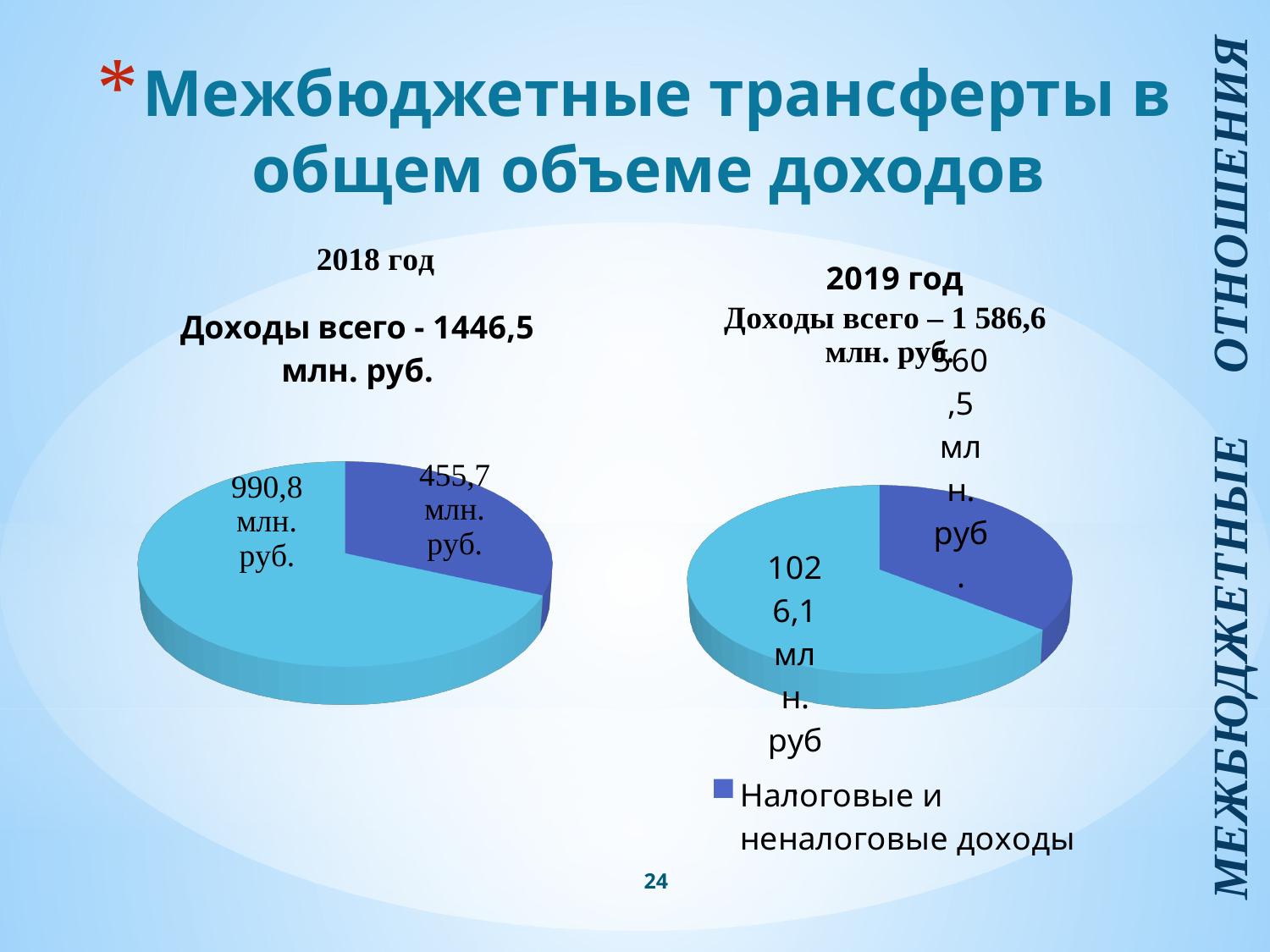
By how much did the dark blue slice (Налоговые и неналоговые доходы) grow from the 2018 год pie chart to the 2019 год pie chart? 104,8 млн. руб. In the 2019 год pie chart, what is the value of the light blue slice? 1026,1 млн. руб. In the 2018 год pie chart, which slice is the largest? The light blue slice, 990,8 млн. руб. How many slices does the 2019 год pie chart have? 2 Is the dark blue slice larger in the 2018 год pie chart or in the 2019 год pie chart? 2019 год In the 2019 год pie chart, what is the value for Налоговые и неналоговые доходы (dark blue slice)? 560,5 млн. руб. In the 2018 год pie chart, what is the difference between the light blue slice and the dark blue slice? 535,1 млн. руб. In the 2018 год pie chart, what is the value of the dark blue slice? 455,7 млн. руб. What legend entry is shown below the 2019 год pie chart? Налоговые и неналоговые доходы In the 2018 год pie chart, what is the value of the light blue slice? 990,8 млн. руб. According to the 2018 год chart heading, what is the total revenue (Доходы всего)? 1446,5 млн. руб. What type of chart is used to show the 2018 and 2019 revenue data on this slide? Pie chart